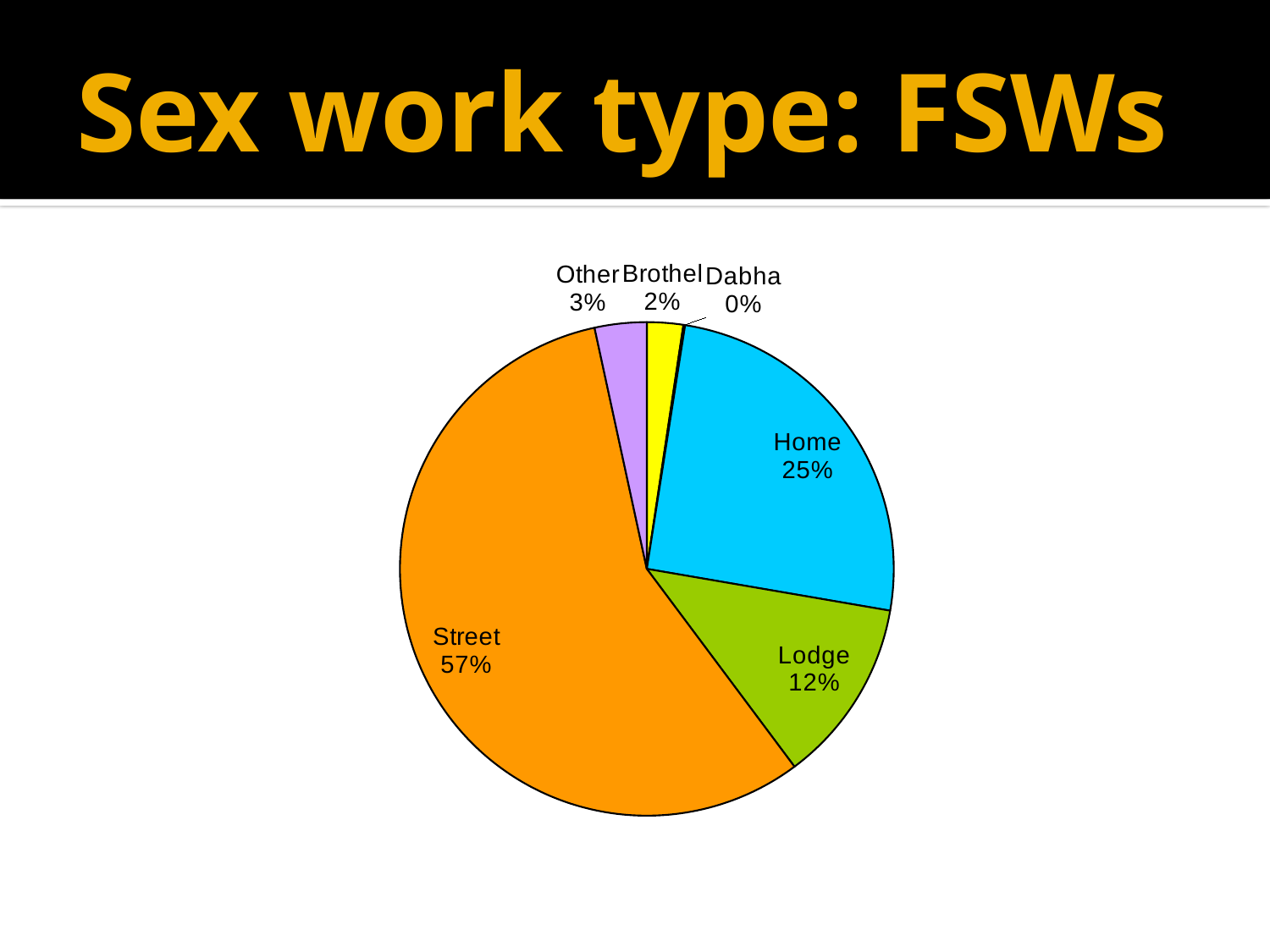
What percentage of FSWs are in the Lodge category? 12% What is the title of the slide? Sex work type: FSWs What percentage of FSWs are in the Home category? 25% What percentage of FSWs are in the Street category? 57% How many categories are shown in the pie chart? 6 What type of chart is shown on the slide? pie chart Which sex work type has the largest share of the pie? Street What is the difference in percentage points between the Street and Home categories? 32 What percentage is shown for the Dabha category? 0% What percentage is shown for the Brothel category? 2% Which sex work type has the smallest share of the pie? Dabha Which is larger, the share for Lodge or the share for Other? Lodge